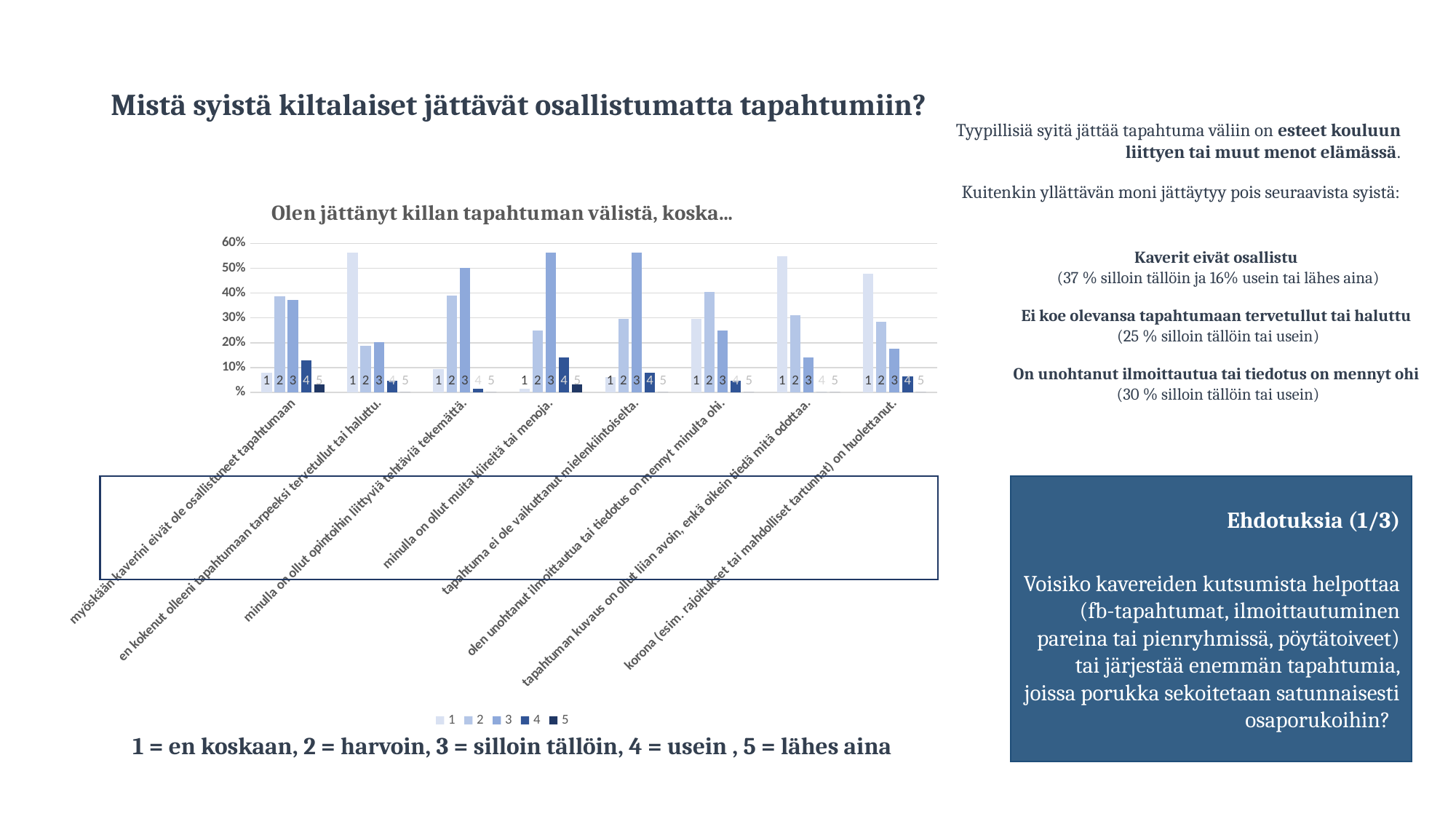
For "tapahtuman kuvaus on ollut liian avoin, enkä oikein tiedä mitä odottaa.", which series has the highest value? 1 What are the legend entries of the chart? 1, 2, 3, 4, 5 Is the value of series 3 for "korona (esim. rajoitukset tai mahdolliset tartunnat) on huolettanut." greater or less than 20%? less How many series does the legend of the chart list? 5 Is the value of series 1 for "en kokenut olleeni tapahtumaan tarpeeksi tervetullut tai haluttu." greater or less than 50%? greater Is the value of series 3 for "minulla on ollut muita kiireitä tai menoja." greater or less than 50%? greater What kind of chart is shown on the slide? bar chart For "minulla on ollut opintoihin liittyviä tehtäviä tekemättä.", which is larger: series 2 or series 3? 3 For "olen unohtanut ilmoittautua tai tiedotus on mennyt ohi.", which is larger: series 1 or series 2? 2 How many categories (reasons) are shown along the x axis of the chart? 8 What is the title of the chart? Olen jättänyt killan tapahtuman välistä, koska…